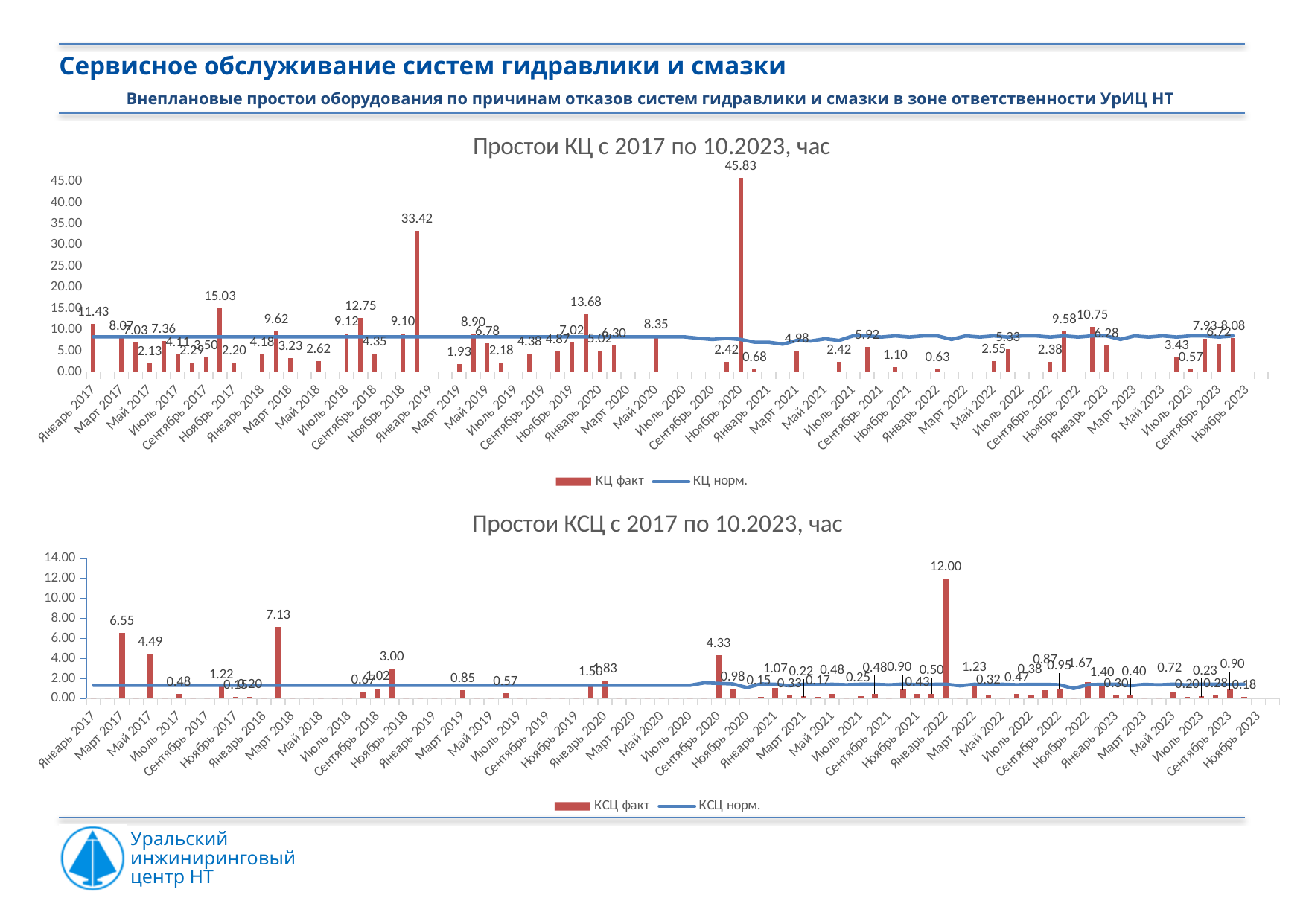
In the top chart (Простои КЦ), what is the value of the КЦ факт bar for Январь 2017? 11.43 In the bottom chart (Простои КСЦ), which is larger: the bar labelled 6.55 or the bar labelled 4.49? 6.55 In the chart titled 'Простои КЦ с 2017 по 10.2023, час', what is the highest value shown for КЦ факт? 45.83 How many series does the legend of the top chart (Простои КЦ) list? 2 In the bottom chart (Простои КСЦ), what is the difference between the two largest bars, 12.00 and 7.13? 4.87 In the top chart (Простои КЦ), what is the difference between the two largest bars, 45.83 and 33.42? 12.41 In the top chart (Простои КЦ), is the value for Ноябрь 2020 greater or less than 40.00? greater What are the legend entries of the bottom chart (Простои КСЦ)? КСЦ факт, КСЦ норм. In the bottom chart (Простои КСЦ), what is the value of the КСЦ факт bar for Январь 2022? 12.00 In the chart titled 'Простои КСЦ с 2017 по 10.2023, час', what is the highest value shown for КСЦ факт? 12.00 What kind of chart is the bottom chart (Простои КСЦ)? bar chart with a line What is the highest tick on the y axis of the top chart (Простои КЦ)? 45.00